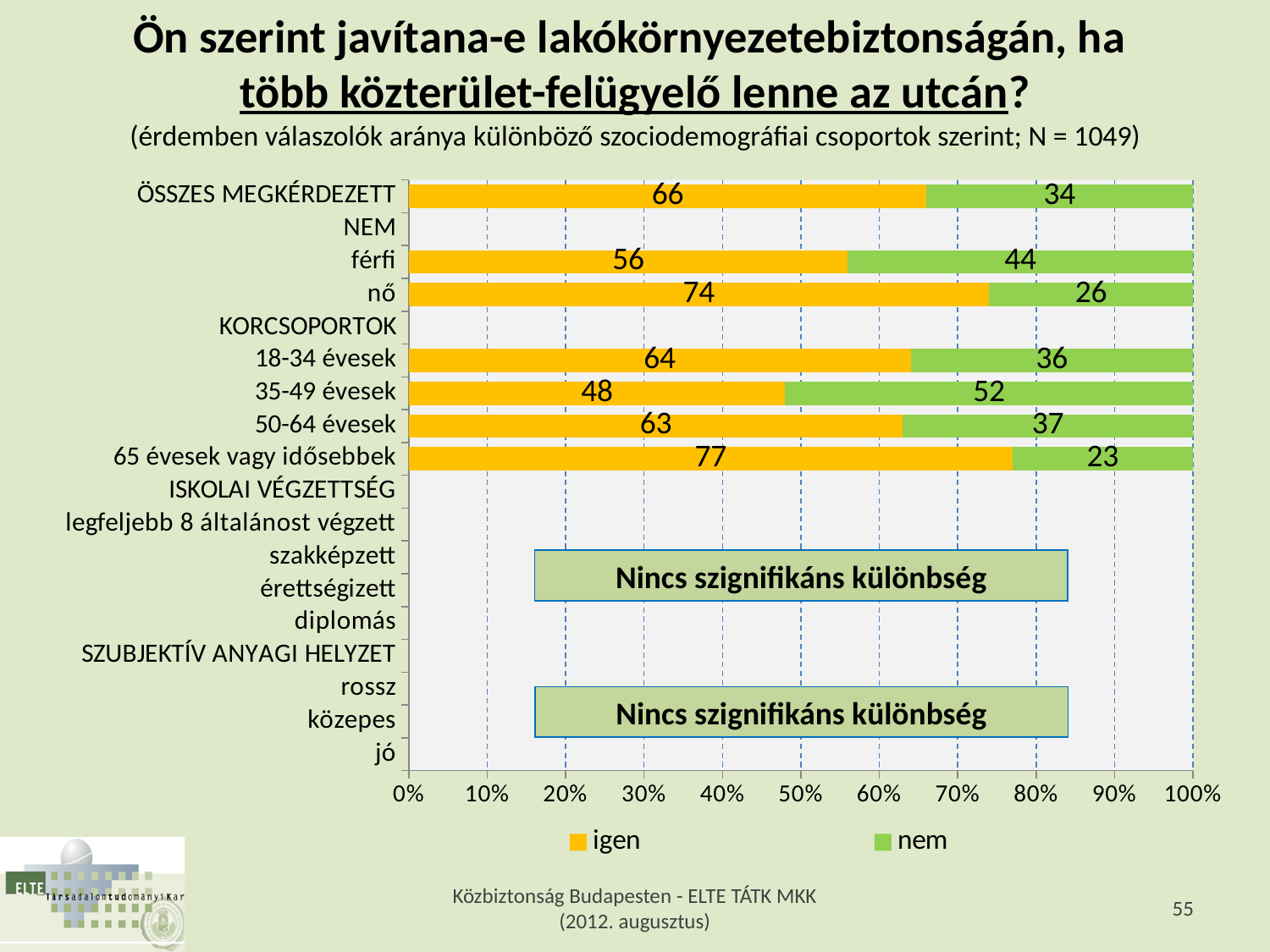
Which category has the highest 'igen' value? 65 évesek vagy idősebbek What is the total of the 'igen' and 'nem' values for 65 évesek vagy idősebbek? 100 What text appears in the boxes placed over the ISKOLAI VÉGZETTSÉG and SZUBJEKTÍV ANYAGI HELYZET rows? Nincs szignifikáns különbség What is the 'igen' value for 35-49 évesek? 48 How many series does the legend list? 2 What is the 'nem' value for férfi? 44 Which has a larger 'nem' value, 18-34 évesek or 50-64 évesek? 50-64 évesek What kind of chart is shown on the slide? Stacked bar chart What is the 'igen' value for ÖSSZES MEGKÉRDEZETT? 66 Which category has the lowest 'igen' value? 35-49 évesek What is the 'nem' value for 50-64 évesek? 37 What is the difference between the 'igen' values for nő and férfi? 18